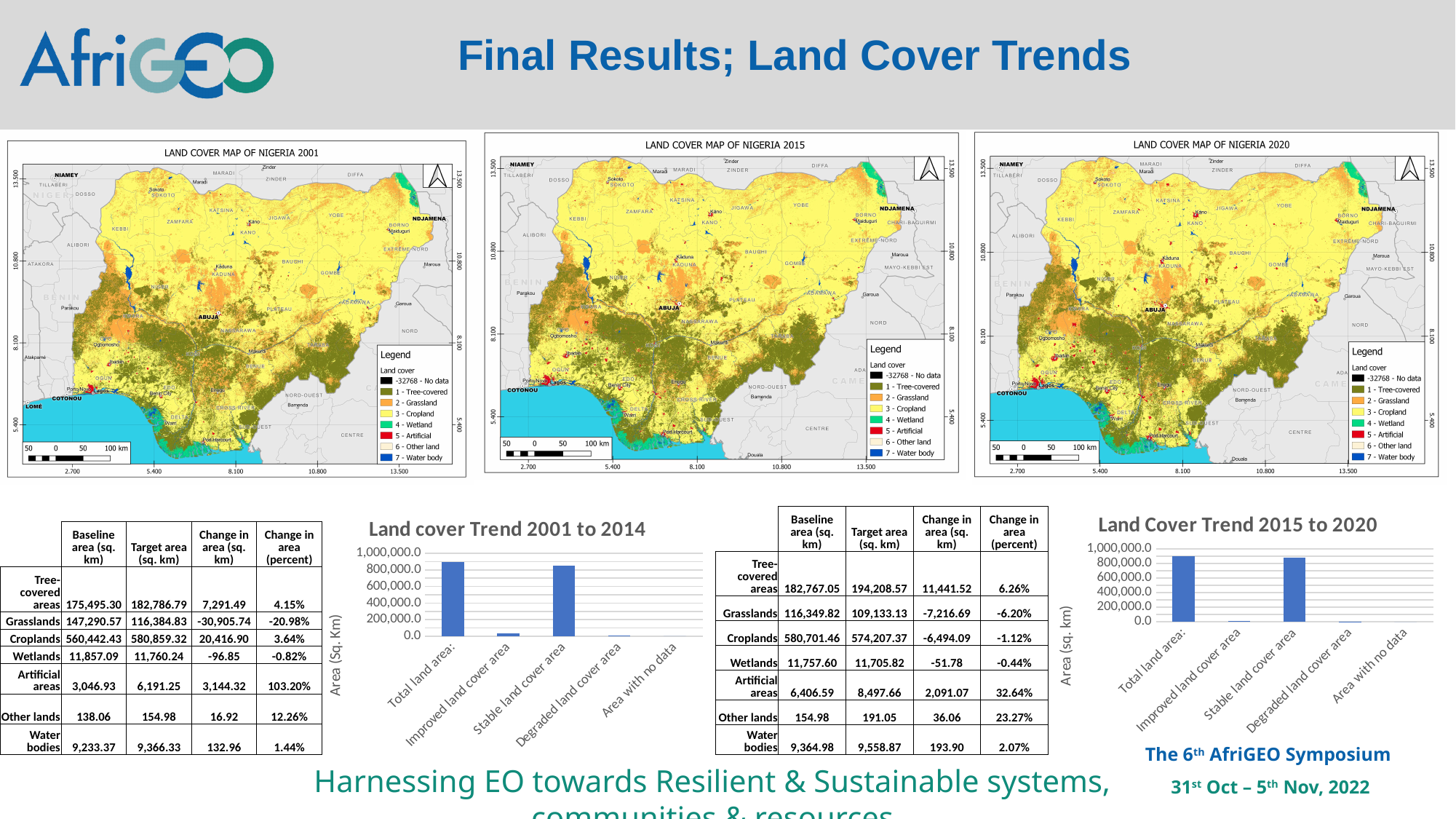
In the 'Land Cover Trend 2015 to 2020' chart, is the value for Stable land cover area greater or less than 600,000.0? greater In the 'Land cover Trend 2001 to 2014' chart, which category has the highest value? Total land area What is the y-axis label of the 'Land cover Trend 2001 to 2014' chart? Area (Sq. Km) In the 'Land cover Trend 2001 to 2014' chart, is the value for Improved land cover area greater or less than 200,000.0? less In the 'Land Cover Trend 2015 to 2020' chart, which category has the highest value? Total land area How many categories are shown on the x axis of the 'Land Cover Trend 2015 to 2020' chart? 5 What kind of chart is the 'Land Cover Trend 2015 to 2020' chart? bar chart How many categories are shown on the x axis of the 'Land cover Trend 2001 to 2014' chart? 5 In the 'Land cover Trend 2001 to 2014' chart, which is larger: Total land area or Stable land cover area? Total land area In the 'Land cover Trend 2001 to 2014' chart, which is larger: Improved land cover area or Degraded land cover area? Improved land cover area In the 'Land cover Trend 2001 to 2014' chart, is the value for Total land area greater or less than 800,000.0? greater What kind of chart is the 'Land cover Trend 2001 to 2014' chart? bar chart